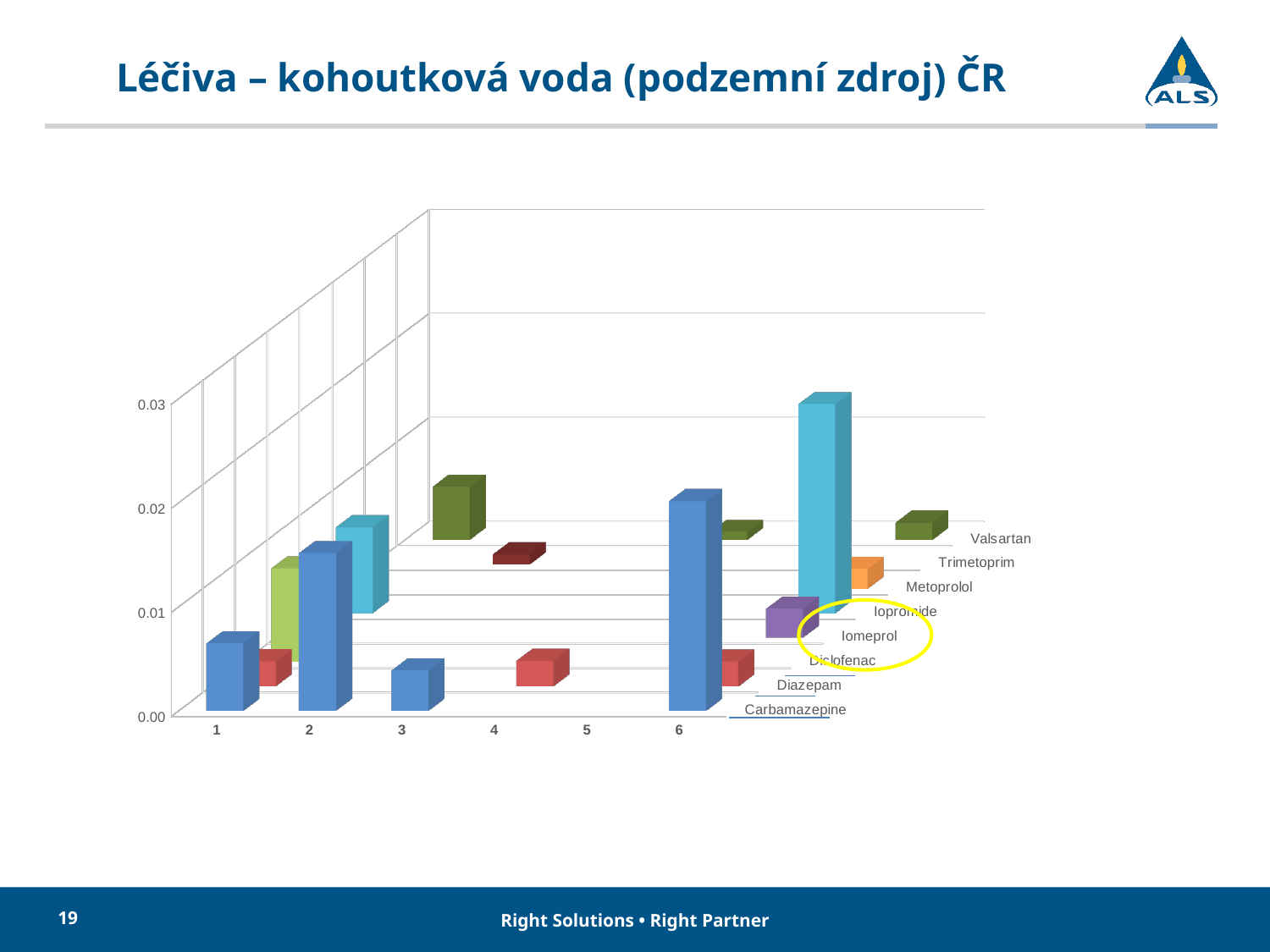
What is the title of the slide containing the chart? Léčiva – kohoutková voda (podzemní zdroj) ČR What is the highest value shown on the vertical axis of the chart? 0.03 For the Carbamazepine series, which is larger: the bar at category 3 or the bar at category 6? category 6 What kind of chart is shown on the slide? bar chart How many numbered categories are shown along the x axis of the chart? 6 Which series is listed first (at the front) on the depth axis of the chart? Carbamazepine Is the Carbamazepine bar at category 6 greater or less than 0.01? greater How many series names are listed along the depth axis of the chart? 8 At which x-axis category does the tallest bar in the chart appear? 6 Is the Carbamazepine bar at category 3 greater or less than 0.01? less